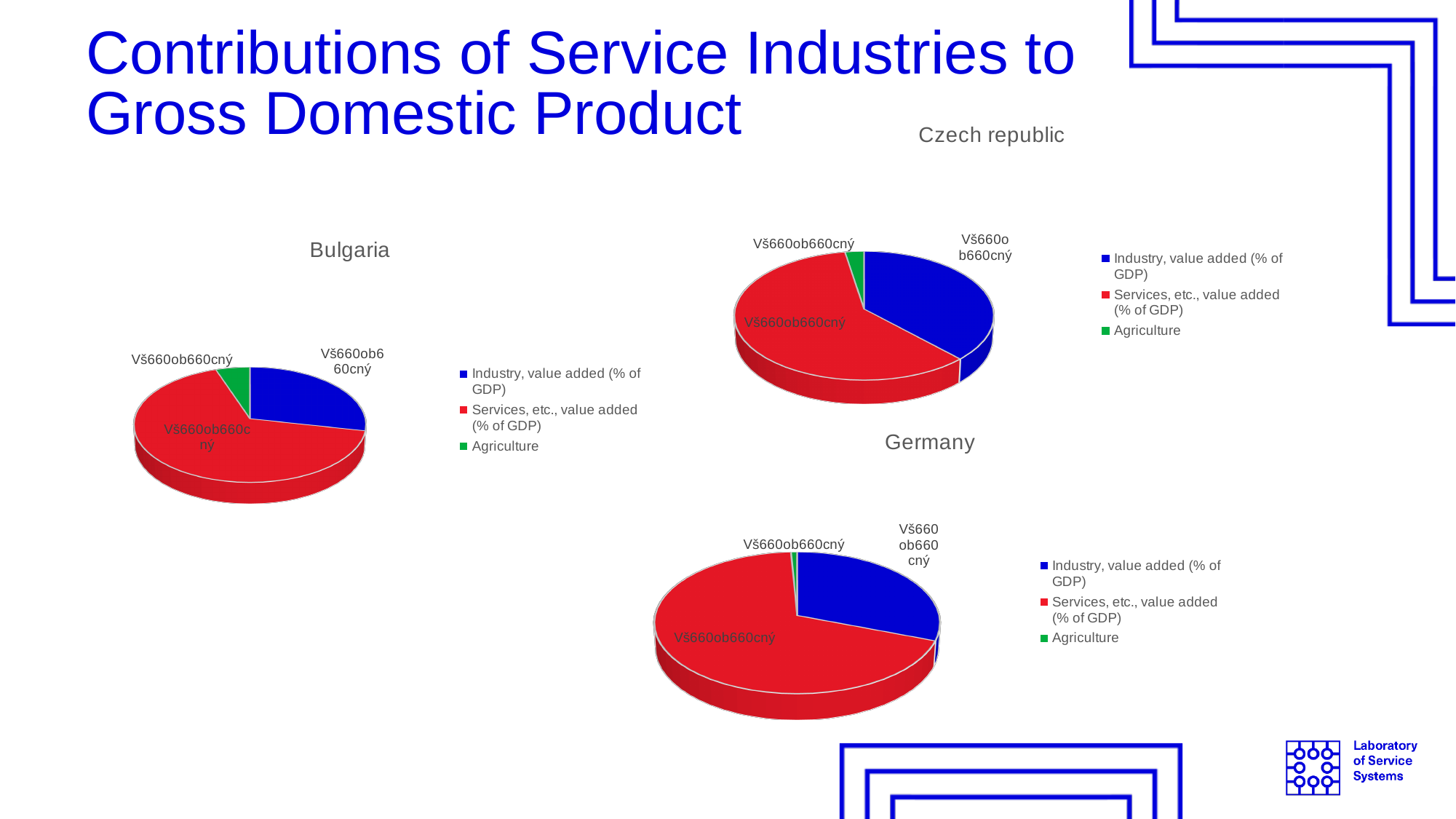
In the Bulgaria chart, which slice is larger: Services or Industry? Services, etc., value added (% of GDP) In the Czech republic chart, which category has the largest slice? Services, etc., value added (% of GDP) Which chart has the larger Agriculture slice: Bulgaria or Germany? Bulgaria What colour represents Agriculture in the legends of the charts? green In the Germany chart, which category has the smallest slice? Agriculture How many entries does the legend of the Czech republic chart list? 3 What is the title of the chart at the bottom of the slide? Germany What kind of chart is the Bulgaria chart? pie chart In the Germany chart, which slice is larger: Industry or Agriculture? Industry, value added (% of GDP) In the Bulgaria chart, which category has the largest slice? Services, etc., value added (% of GDP) How many pie charts are on the slide? 3 In the Czech republic chart, which category has the smallest slice? Agriculture